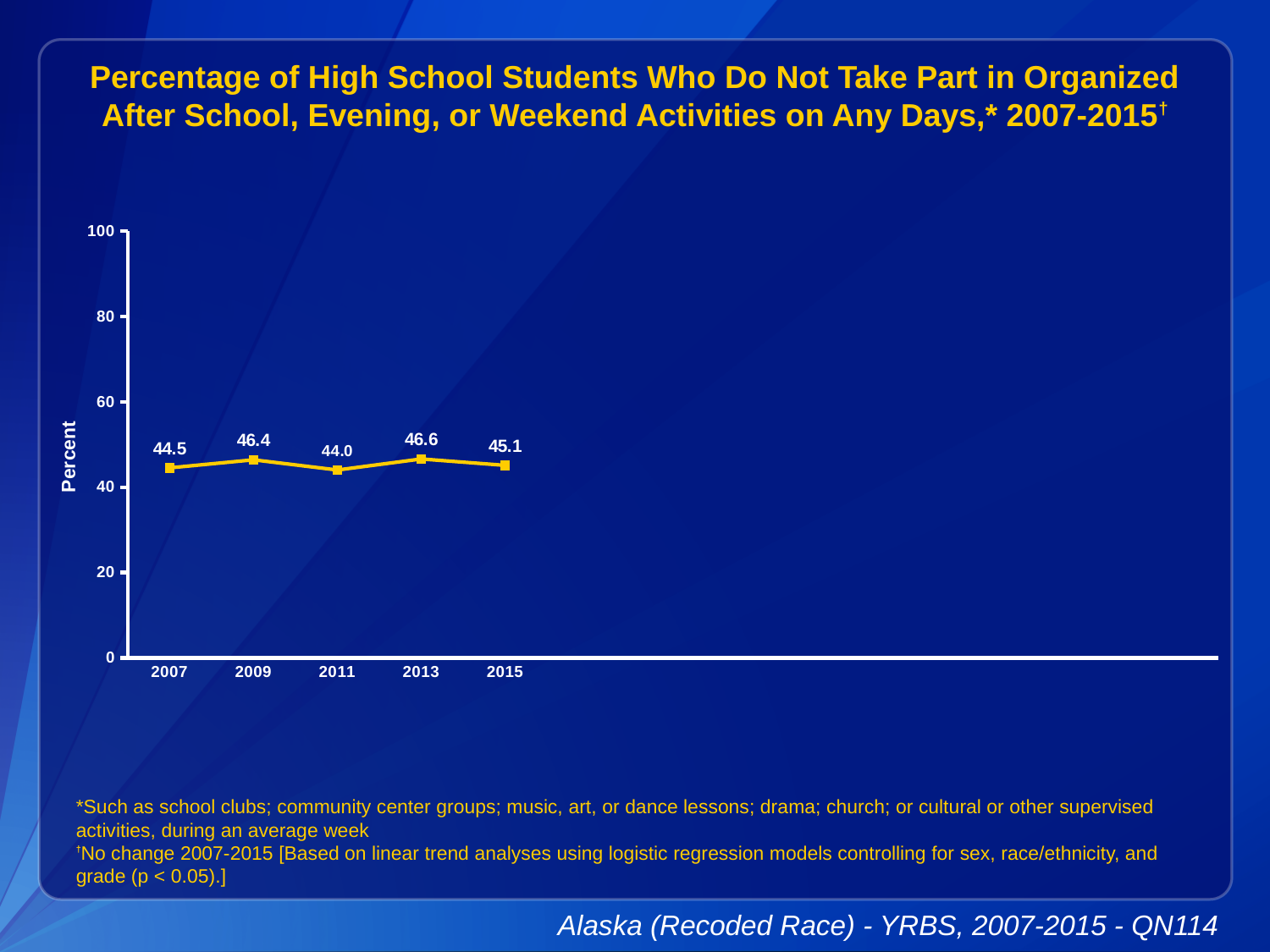
What is the value for 2011? 44.0 What is the difference between the values for 2009 and 2007? 1.9 Which is larger, the value for 2009 or the value for 2015? 2009 What is the difference between the values for 2013 and 2011? 2.6 What is the value for 2015? 45.1 How many years are plotted on the chart? 5 Which year has the lowest value? 2011 What is the value for 2007? 44.5 Is the value for 2013 greater or less than 60? less Which year has the highest value? 2013 What is the label of the y axis? Percent What kind of chart is shown on the slide? line chart